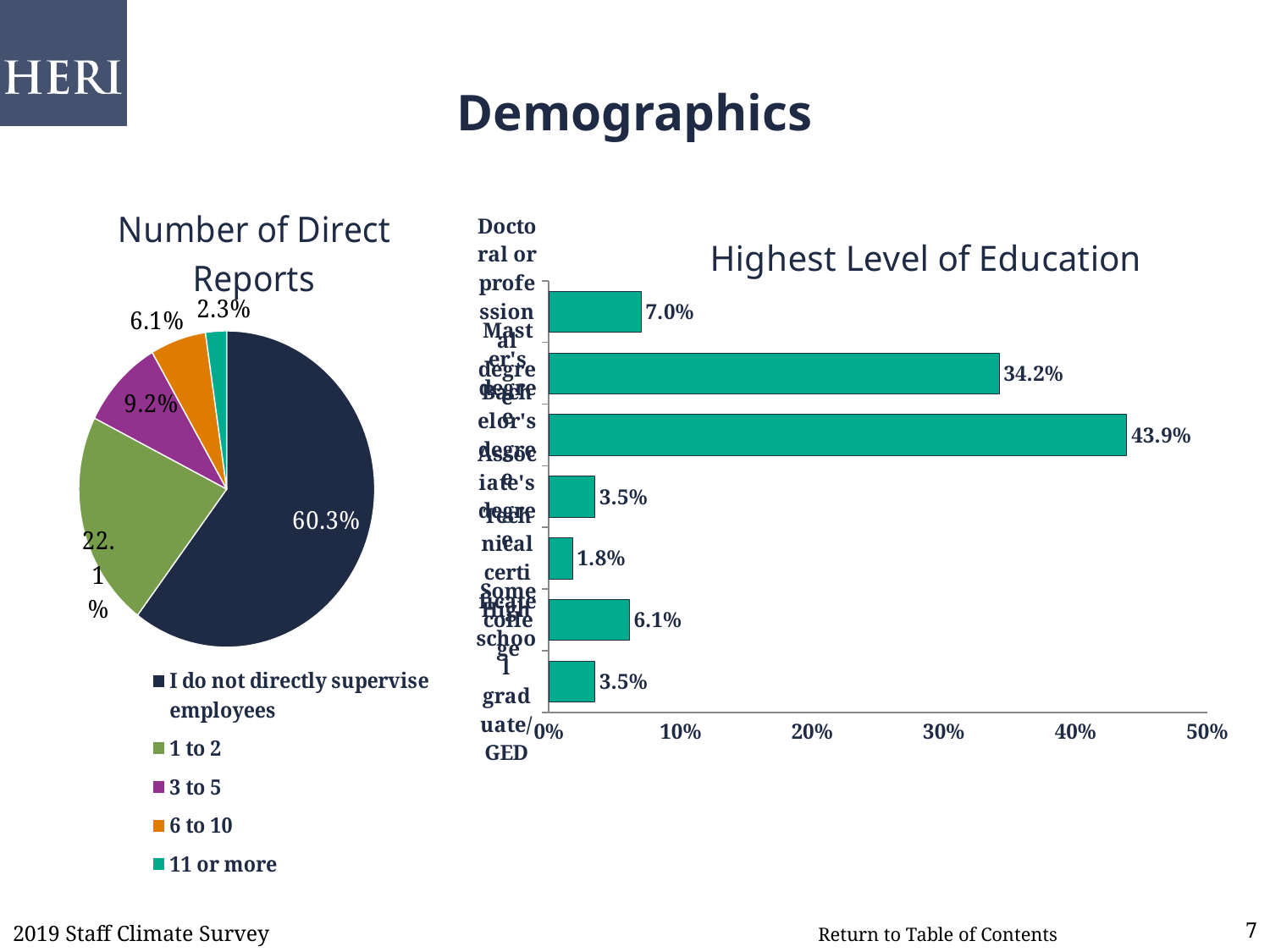
In the Number of Direct Reports pie chart, what share is shown for 'I do not directly supervise employees'? 60.3% In the Number of Direct Reports pie chart, which category has the smallest slice? 11 or more In the Highest Level of Education chart, how many bars are plotted? 7 In the Number of Direct Reports pie chart, how many categories does the legend list? 5 In the Number of Direct Reports pie chart, what percentage is shown for '1 to 2'? 22.1% In the Highest Level of Education chart, is the longest bar greater or less than 40%? greater What kind of chart is the Highest Level of Education chart? bar chart In the Highest Level of Education chart, what is the value of the topmost bar? 7.0% In the Number of Direct Reports pie chart, what percentage is shown for '3 to 5'? 9.2% In the Highest Level of Education chart, what is the lowest value shown? 1.8% In the Number of Direct Reports pie chart, what is the difference between the '6 to 10' and '11 or more' percentages? 3.8% In the Highest Level of Education chart, what is the highest value shown? 43.9%